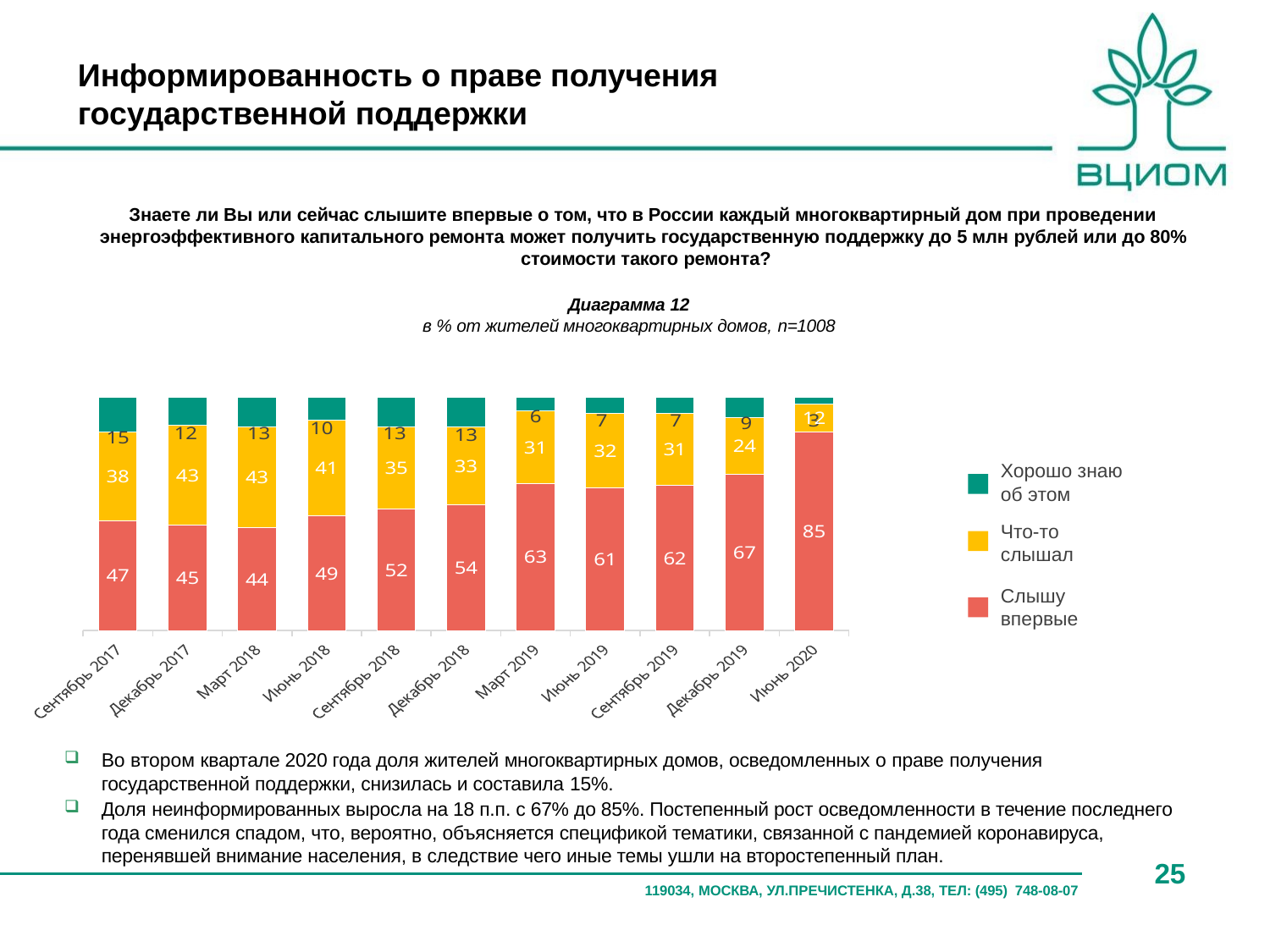
What is the difference between the 'Слышу впервые' values for Июнь 2020 and Декабрь 2019? 18 How many periods are shown on the x axis of the chart? 11 How many series does the legend list? 3 What is the value of 'Слышу впервые' for Июнь 2020? 85 Which period has the lowest value for 'Слышу впервые'? Март 2018 What kind of chart is shown on the slide? Stacked bar chart What is the value of 'Что-то слышал' for Декабрь 2019? 24 Which is larger: the 'Что-то слышал' value for Сентябрь 2018 or for Декабрь 2018? Сентябрь 2018 Which period has the highest value for 'Слышу впервые'? Июнь 2020 Does the 'Слышу впервые' series generally rise or fall from Сентябрь 2017 to Июнь 2020? Rise What is the value of 'Слышу впервые' for Март 2019? 63 What is the value of 'Что-то слышал' for Декабрь 2017? 43